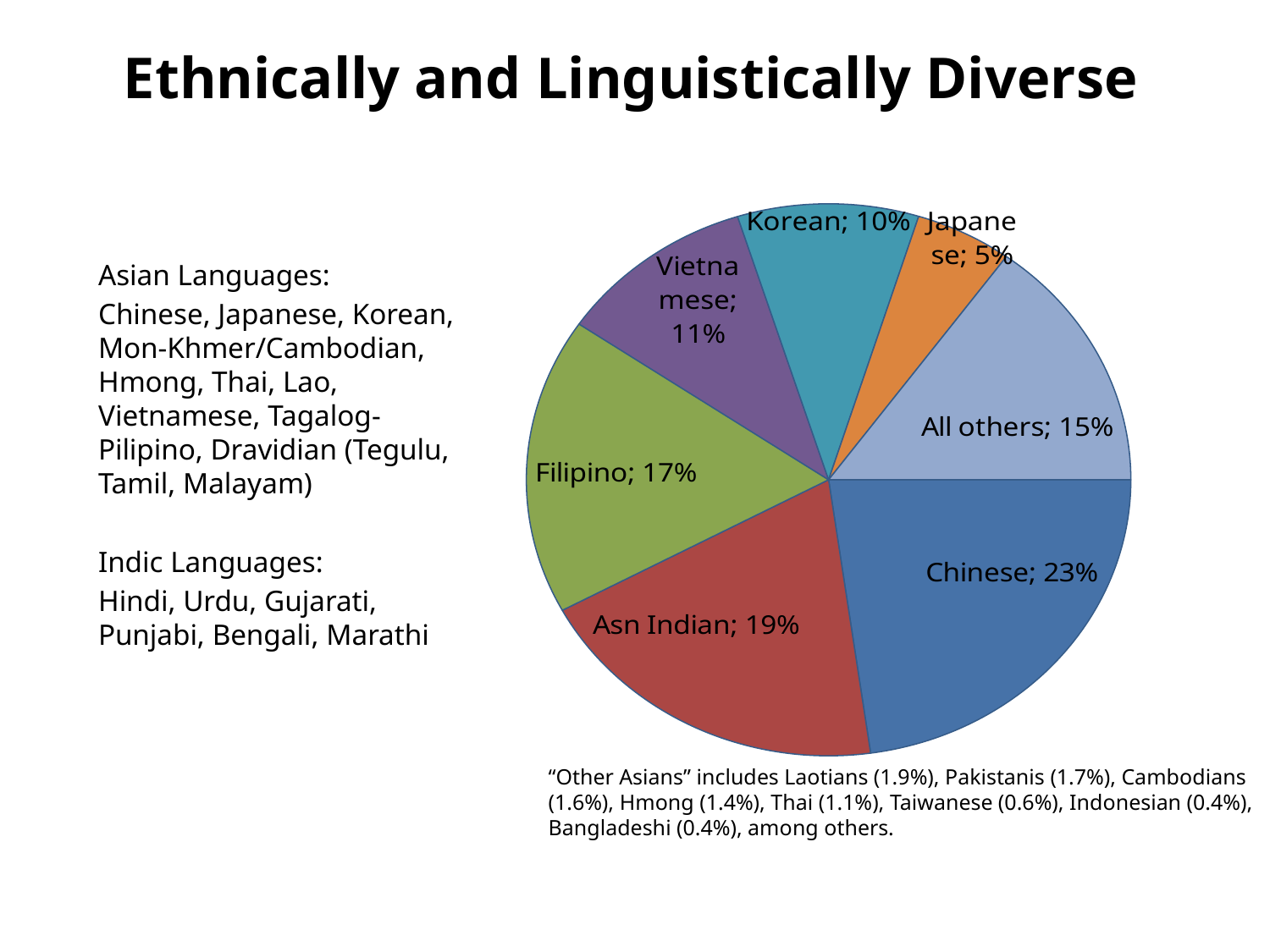
What colour is the Asn Indian slice of the pie chart? red What is the difference in percentage points between the Chinese and Korean slices? 13 What percentage of the pie chart is Asn Indian? 19% How many slices does the pie chart have? 7 Which slice is larger, Filipino or All others? Filipino What kind of chart is shown on the slide? pie chart Which slice of the pie chart is the smallest? Japanese What percentage of the pie chart is Japanese? 5% Which slice of the pie chart is the largest? Chinese What percentage of the pie chart is Vietnamese? 11% What percentage of the pie chart is Chinese? 23% What percentage of the pie chart is Filipino? 17%